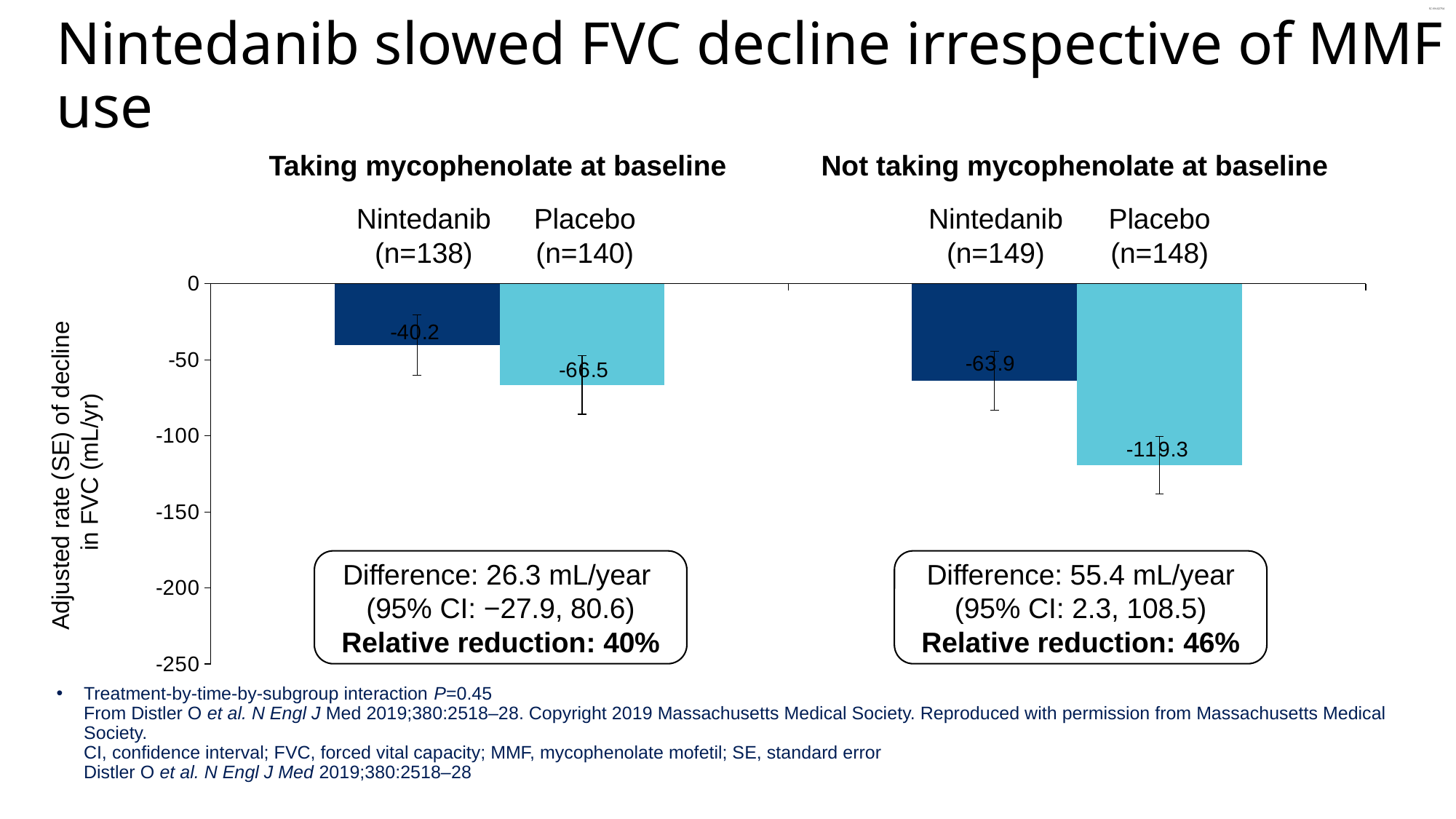
How many bars are plotted on the chart? 4 Is the decline in FVC for placebo in the group not taking mycophenolate at baseline greater or less than 100 mL/yr in magnitude? greater What is the label of the vertical axis? Adjusted rate (SE) of decline in FVC (mL/yr) What is the difference between the placebo and nintedanib values in the group taking mycophenolate at baseline? 26.3 What is the adjusted rate of decline in FVC for placebo in the group taking mycophenolate at baseline? -66.5 What is the adjusted rate of decline in FVC for placebo in the group not taking mycophenolate at baseline? -119.3 Which bar shows the smallest decline in FVC (the value closest to zero)? Nintedanib, taking mycophenolate at baseline What is the difference between the placebo and nintedanib values in the group not taking mycophenolate at baseline? 55.4 Which bar shows the largest decline in FVC (the most negative value)? Placebo, not taking mycophenolate at baseline What is the adjusted rate of decline in FVC for nintedanib in the group not taking mycophenolate at baseline? -63.9 What is the adjusted rate of decline in FVC for nintedanib in the group taking mycophenolate at baseline? -40.2 What kind of chart is shown on the slide? Bar chart